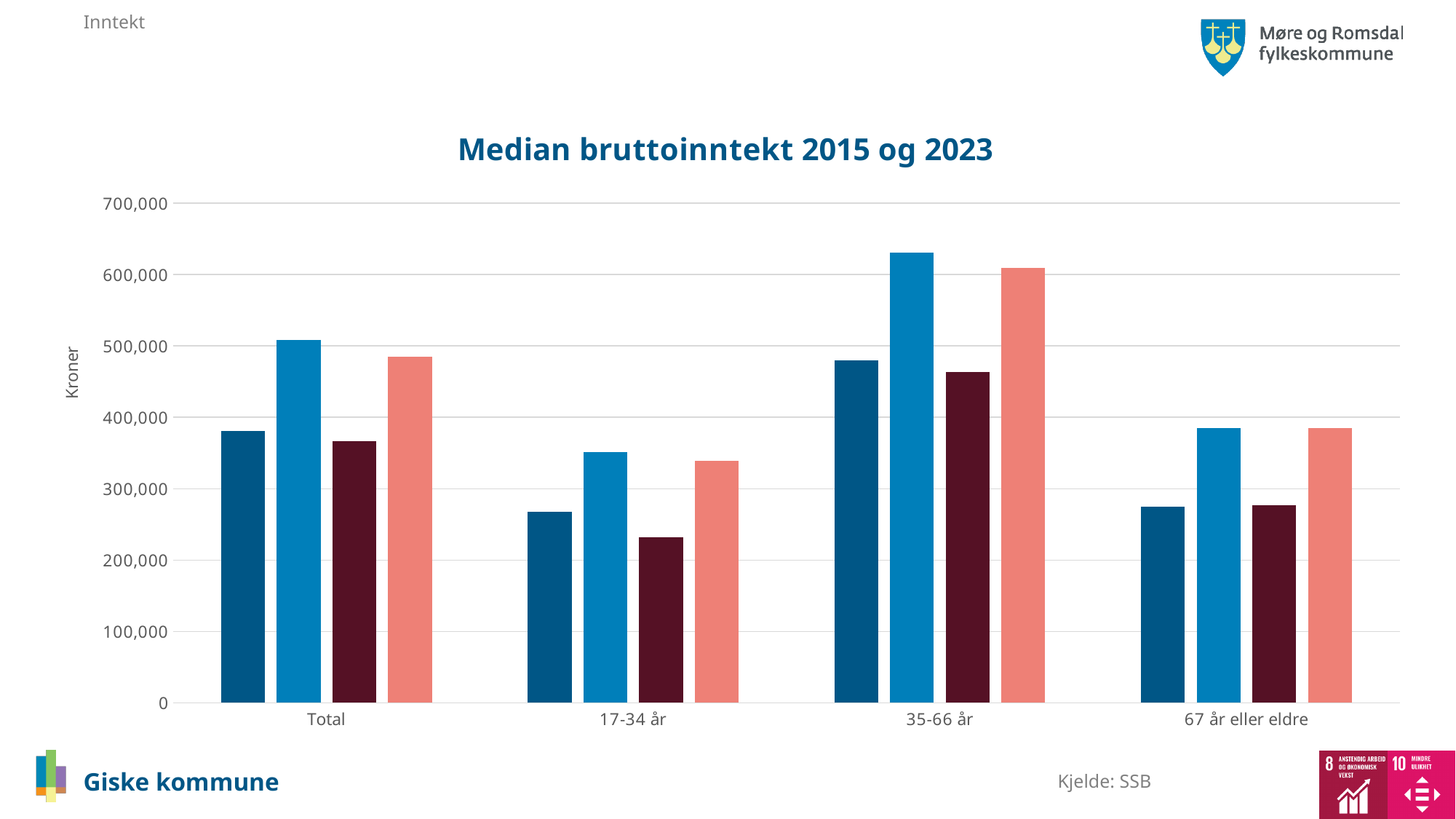
Is the dark blue bar for 17-34 år greater or less than 300,000? less Which category has the lowest light blue bar on the chart? 17-34 år Is the dark red bar for 35-66 år greater or less than 500,000? less Which is larger: the dark blue bar for Total or the dark blue bar for 67 år eller eldre? Total How many categories are shown on the x axis of the chart? 4 Is the light blue bar for 35-66 år greater or less than 600,000? greater What is the label on the vertical axis of the chart? Kroner Which category has the tallest bars on the chart? 35-66 år What kind of chart is shown on the slide? bar chart What is the title of the chart? Median bruttoinntekt 2015 og 2023 How many bars are plotted for each category on the chart? 4